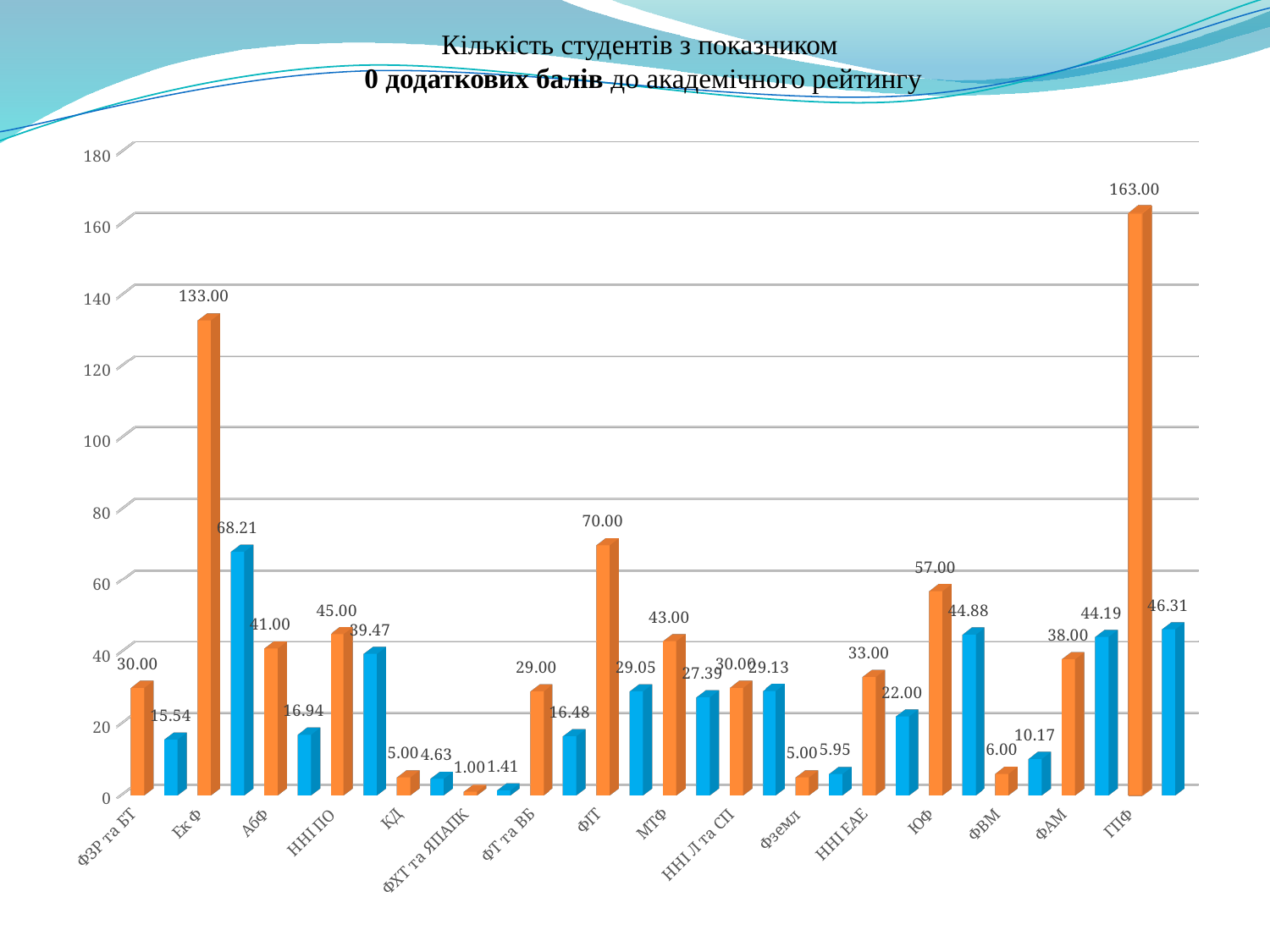
Which category has the lowest orange bar? ФХТ та ЯПАПК What is the difference between the orange bars for ГПФ and Ек Ф? 30.00 What is the value of the orange bar for ГПФ? 163.00 What is the value of the orange bar for ФІТ? 70.00 What is the difference between the orange and blue bars for ННІ ЕАЕ? 11.00 Is the value of the orange bar for Ек Ф greater or less than 120? greater Which category has the highest orange bar? ГПФ What is the value of the blue bar for Ек Ф? 68.21 What is the value of the blue bar for ЮФ? 44.88 What type of chart is shown on the slide? bar chart How many categories are shown along the x axis of the chart? 16 Which is larger for ФАМ: the orange bar or the blue bar? the blue bar